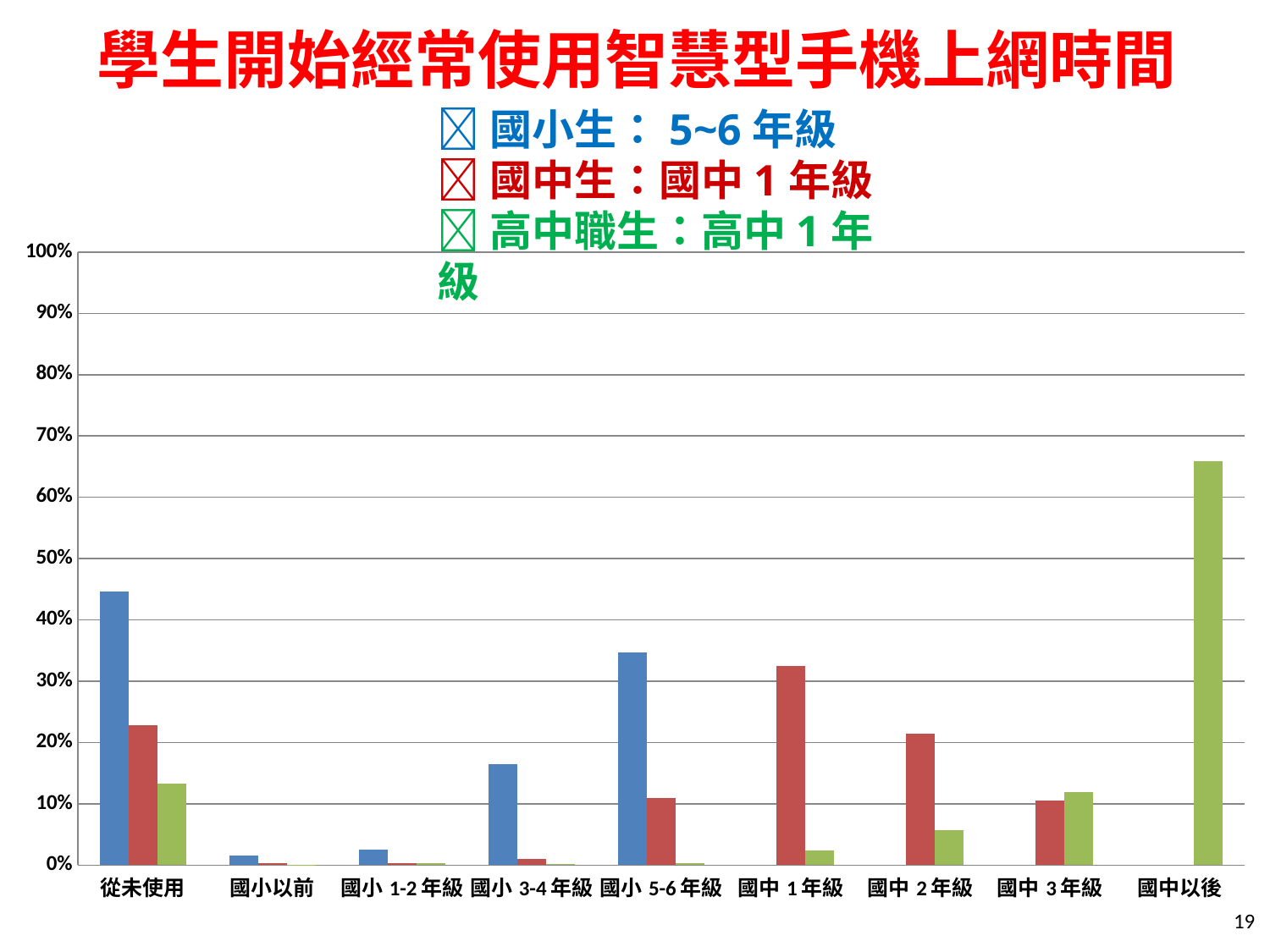
Is the blue bar for 國小 3-4 年級 greater or less than 20%? less How many categories are shown along the x axis? 9 Is the red bar for 國中 1年級 greater or less than 30%? greater What kind of chart is shown on the slide? bar chart For 從未使用, which is larger: the blue bar or the red bar? the blue bar Do the blue bars rise or fall from 國小以前 to 國小 5-6 年級? rise Among the red bars, which category is highest? 國中 1年級 Is the green bar for 國中以後 greater or less than 60%? greater How many differently coloured bar series are plotted in the chart? 3 Which category has the tallest bar in the chart? 國中以後